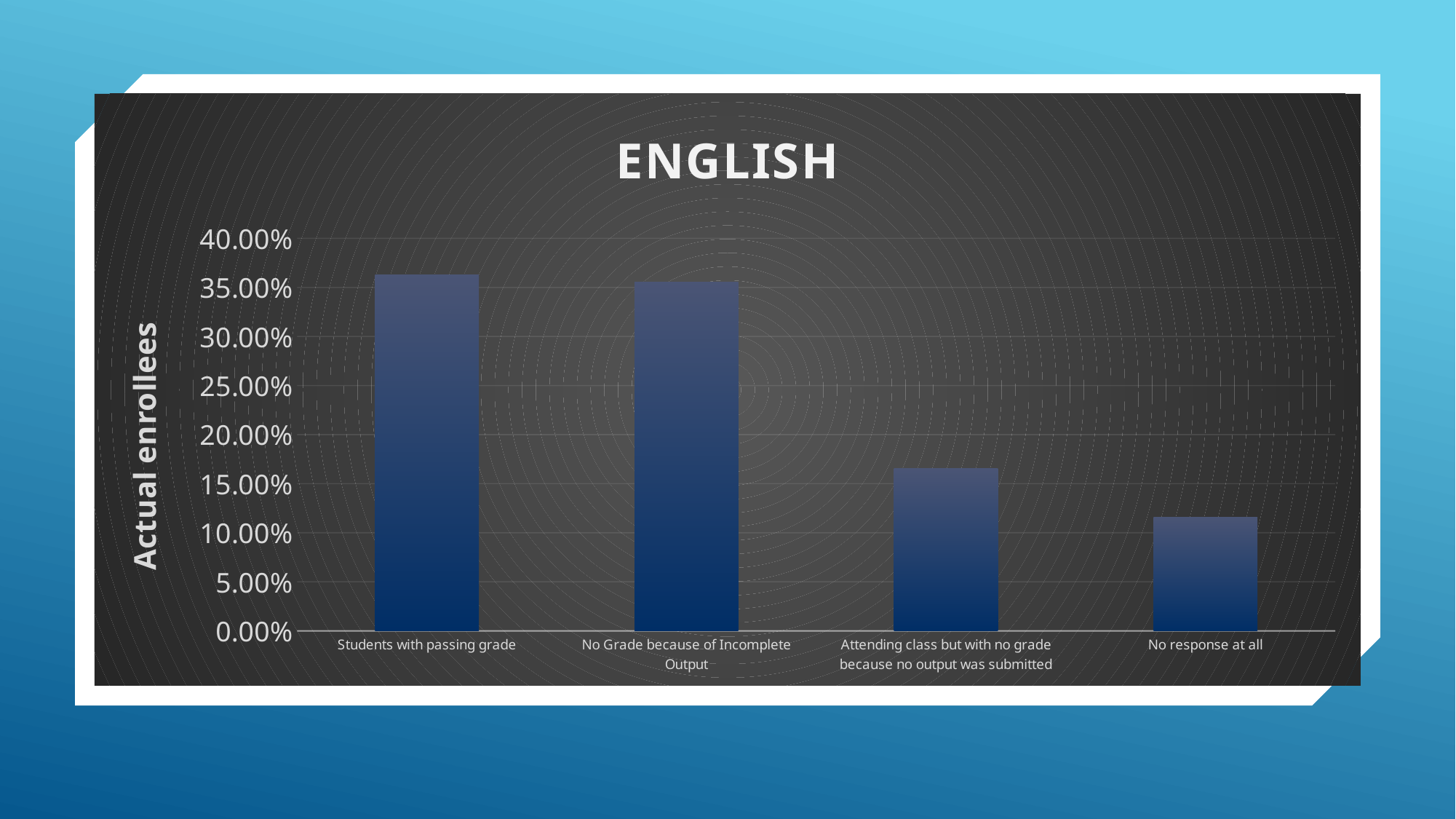
Do the values rise or fall moving from left to right along the x axis? fall Is the value for No Grade because of Incomplete Output greater or less than 30.00%? greater Which category has the lowest value in the chart? No response at all Is the value for Attending class but with no grade because no output was submitted greater or less than 20.00%? less Which is larger: the value for Attending class but with no grade because no output was submitted or the value for No response at all? Attending class but with no grade because no output was submitted What kind of chart is shown on the slide? bar chart Is the value for No response at all greater or less than 10.00%? greater How many categories are shown on the x axis of the chart? 4 What is the title of the chart? ENGLISH What is the label on the vertical axis of the chart? Actual enrollees